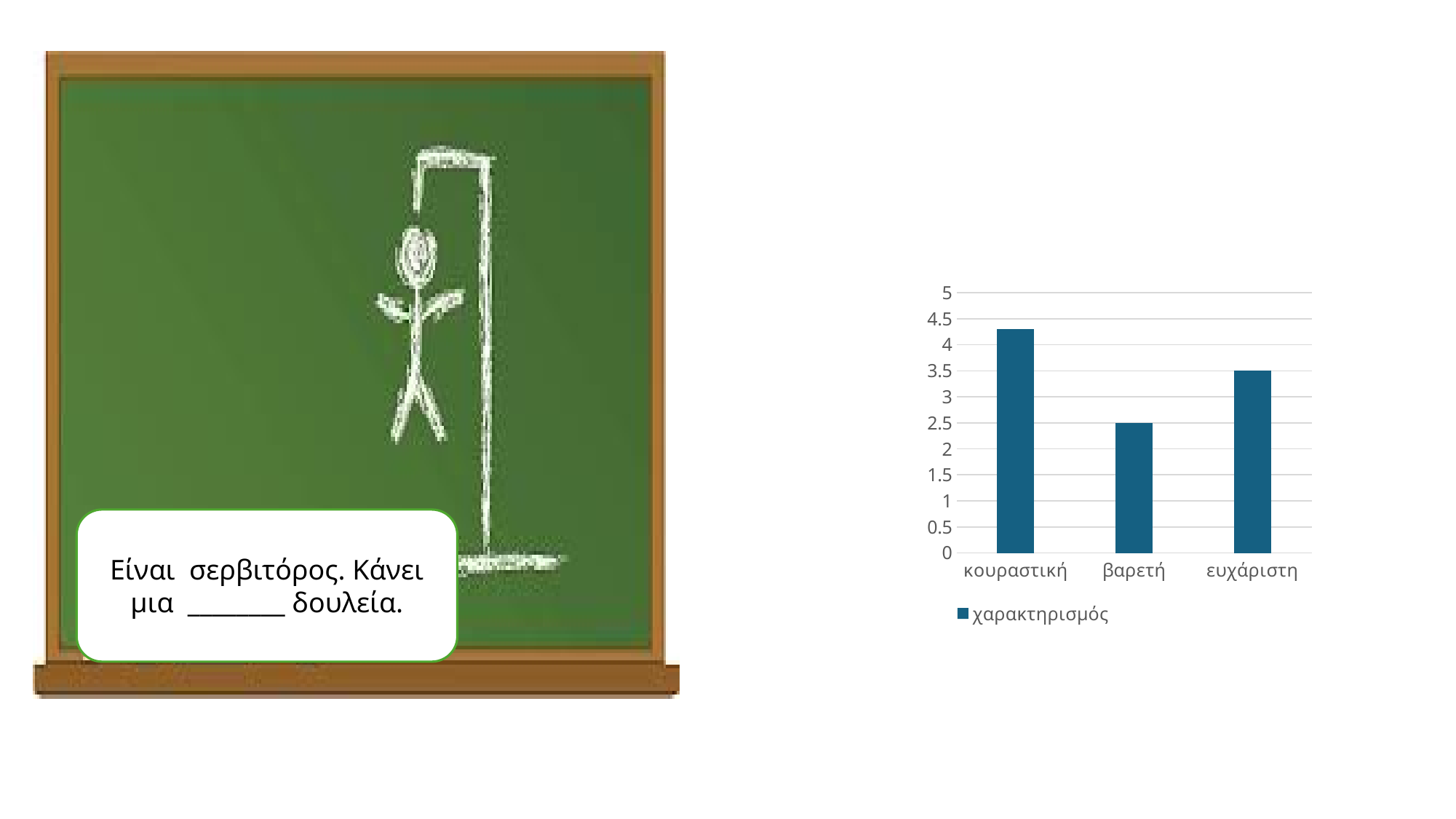
What is the value for βαρετή in the chart? 2.5 What is the highest value shown on the chart's vertical axis? 5 What kind of chart is shown on the slide? bar chart Which category has the highest bar in the chart? κουραστική How many categories are shown on the x axis of the chart? 3 How many series does the chart legend list? 1 Which category has the lowest bar in the chart? βαρετή Which is larger, the value for κουραστική or the value for ευχάριστη? κουραστική What is the value for ευχάριστη in the chart? 3.5 Is the value for κουραστική greater or less than 4? greater What is the difference between the values for ευχάριστη and βαρετή? 1 What is the name of the series in the chart legend? χαρακτηρισμός